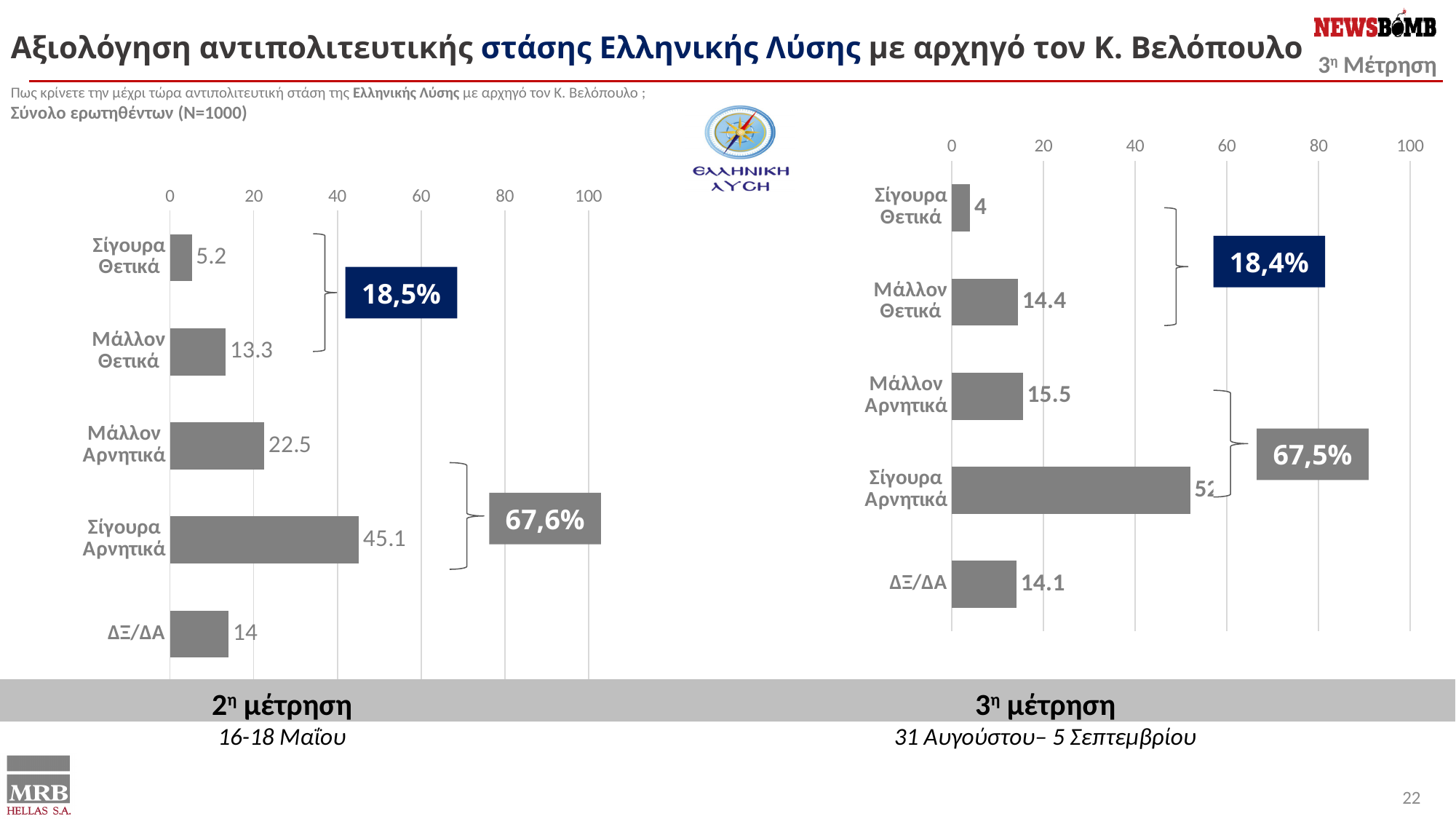
In the left chart (2η μέτρηση), what is the value for Σίγουρα Αρνητικά? 45.1 In the right chart (3η μέτρηση), which category has the lowest value? Σίγουρα Θετικά How many categories does the left chart (2η μέτρηση) show? 5 In the left chart (2η μέτρηση), what is the value for Σίγουρα Θετικά? 5.2 In the right chart (3η μέτρηση), is the value for Σίγουρα Αρνητικά greater or less than 40? greater In the left chart (2η μέτρηση), which category has the highest value? Σίγουρα Αρνητικά In the left chart (2η μέτρηση), what is the difference between Μάλλον Αρνητικά and Μάλλον Θετικά? 9.2 What type of chart is used for the 3η μέτρηση data? Bar chart In the right chart (3η μέτρηση), which is larger: Μάλλον Αρνητικά or Μάλλον Θετικά? Μάλλον Αρνητικά In the right chart (3η μέτρηση), what is the value for ΔΞ/ΔΑ? 14.1 In the right chart (3η μέτρηση), what combined percentage is shown in the dark blue box for the positive categories? 18,4% In the right chart (3η μέτρηση), what is the value for Μάλλον Θετικά? 14.4